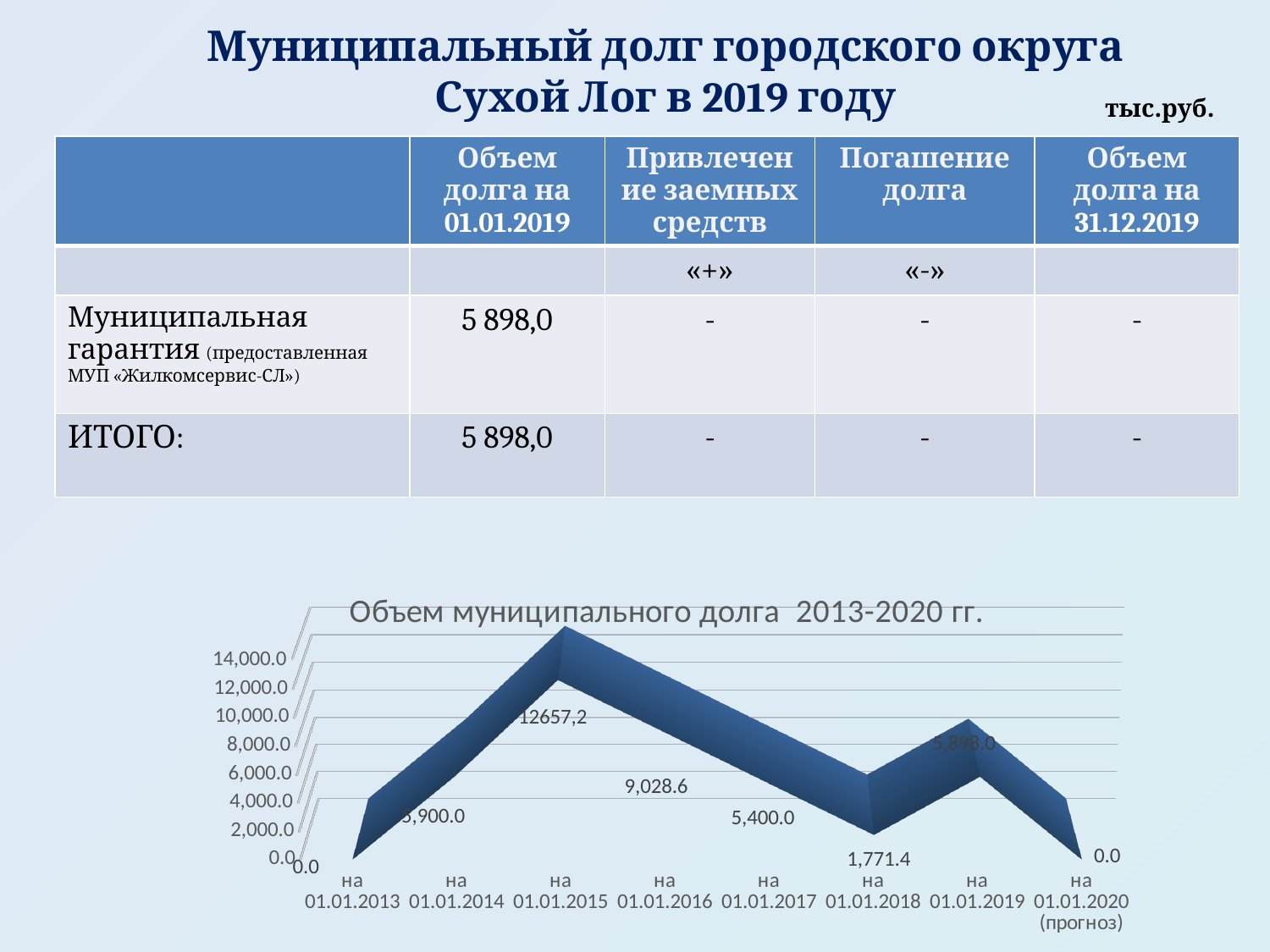
Which date has the highest value on the chart? на 01.01.2015 What is the value for на 01.01.2016? 9,028.6 What is the value for на 01.01.2020 (прогноз)? 0.0 Which is larger, the value for на 01.01.2016 or the value for на 01.01.2017? на 01.01.2016 What is the value for на 01.01.2018? 1,771.4 What is the title of the chart? Объем муниципального долга 2013-2020 гг. What is the value for на 01.01.2019? 5,898.0 Is the value for на 01.01.2015 greater or less than 12,000.0? greater What is the difference between the values for на 01.01.2017 and на 01.01.2018? 3,628.6 What is the value for на 01.01.2015? 12657,2 What kind of chart is shown on the slide? line chart How many data points are plotted on the chart? 8